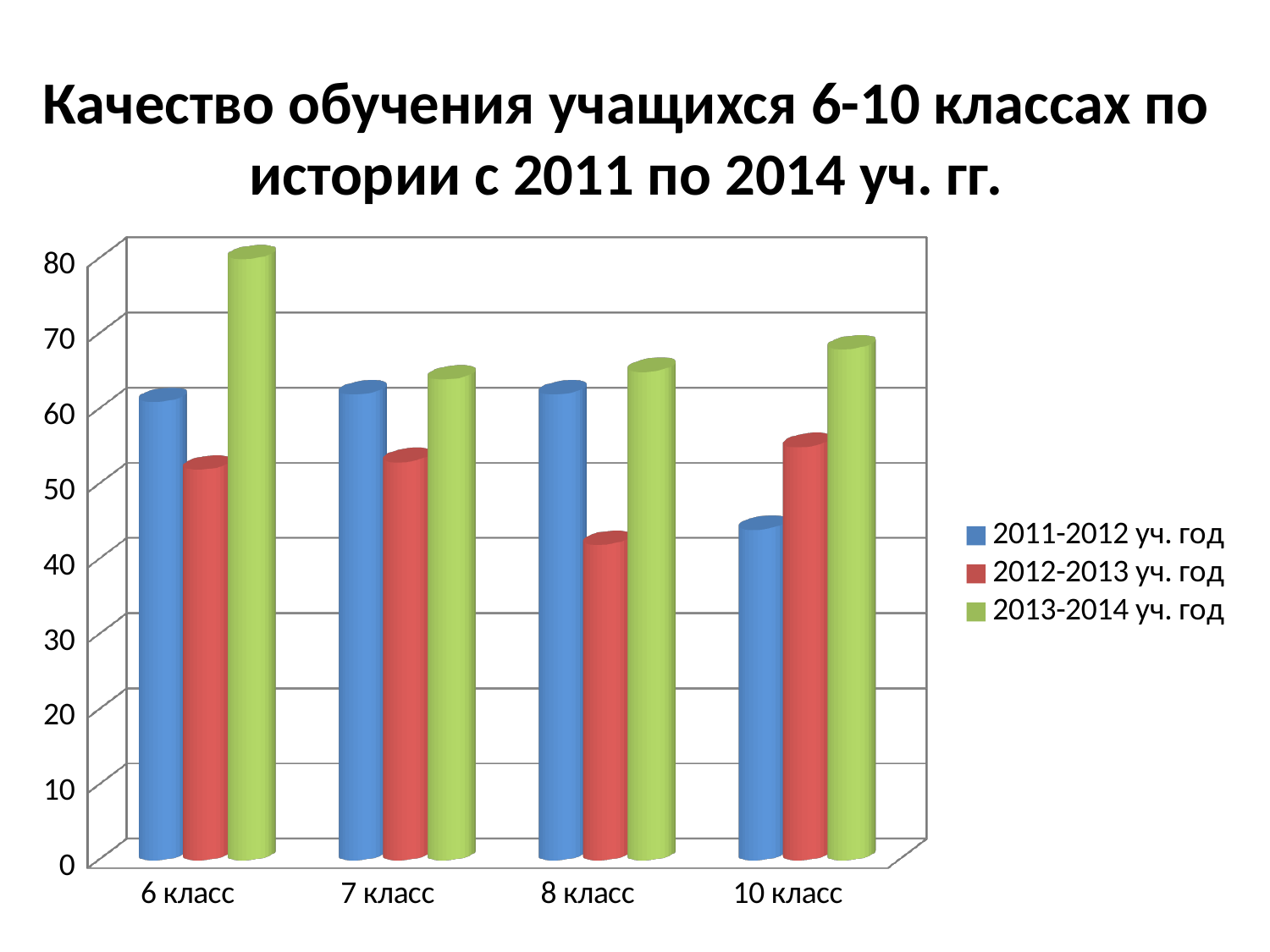
Which class has the lowest value in the 2012-2013 уч. год series? 8 класс For 10 класс, which series has the larger value: 2011-2012 уч. год or 2012-2013 уч. год? 2012-2013 уч. год Is the value for 10 класс in the 2013-2014 уч. год series greater or less than 60? greater Is the value for 6 класс in the 2013-2014 уч. год series greater or less than 70? greater How many series does the legend list? 3 Which class has the highest value in the 2013-2014 уч. год series? 6 класс Which colour represents the 2013-2014 уч. год series in the legend? Green Which class has the lowest value in the 2011-2012 уч. год series? 10 класс How many class categories are shown on the x axis? 4 Is the value for 10 класс in the 2011-2012 уч. год series greater or less than 50? less What kind of chart is shown on the slide? Bar chart